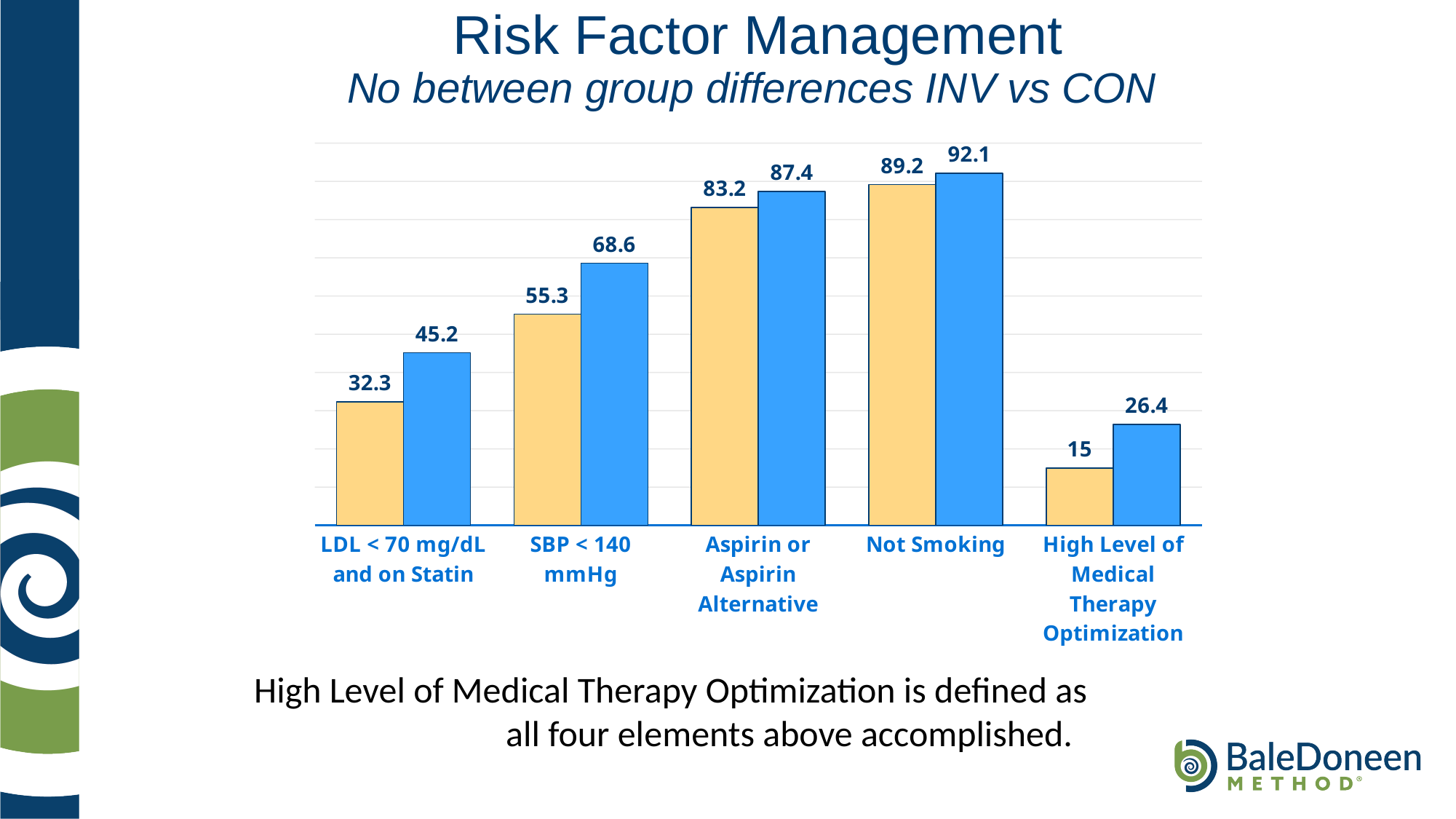
How many categories are shown on the x axis? 5 Which category has the lowest yellow bar? High Level of Medical Therapy Optimization Which is larger for LDL < 70 mg/dL and on Statin, the yellow bar or the blue bar? the blue bar What is the difference between the blue and yellow bars for Aspirin or Aspirin Alternative? 4.2 What is the value of the yellow bar for Not Smoking? 89.2 What is the difference between the blue and yellow bars for SBP < 140 mmHg? 13.3 What is the value of the blue bar for LDL < 70 mg/dL and on Statin? 45.2 What is the value of the blue bar for SBP < 140 mmHg? 68.6 What kind of chart is shown on the slide? bar chart Which category has the highest blue bar? Not Smoking What is the value of the yellow bar for High Level of Medical Therapy Optimization? 15 What is the title of the slide containing the chart? Risk Factor Management